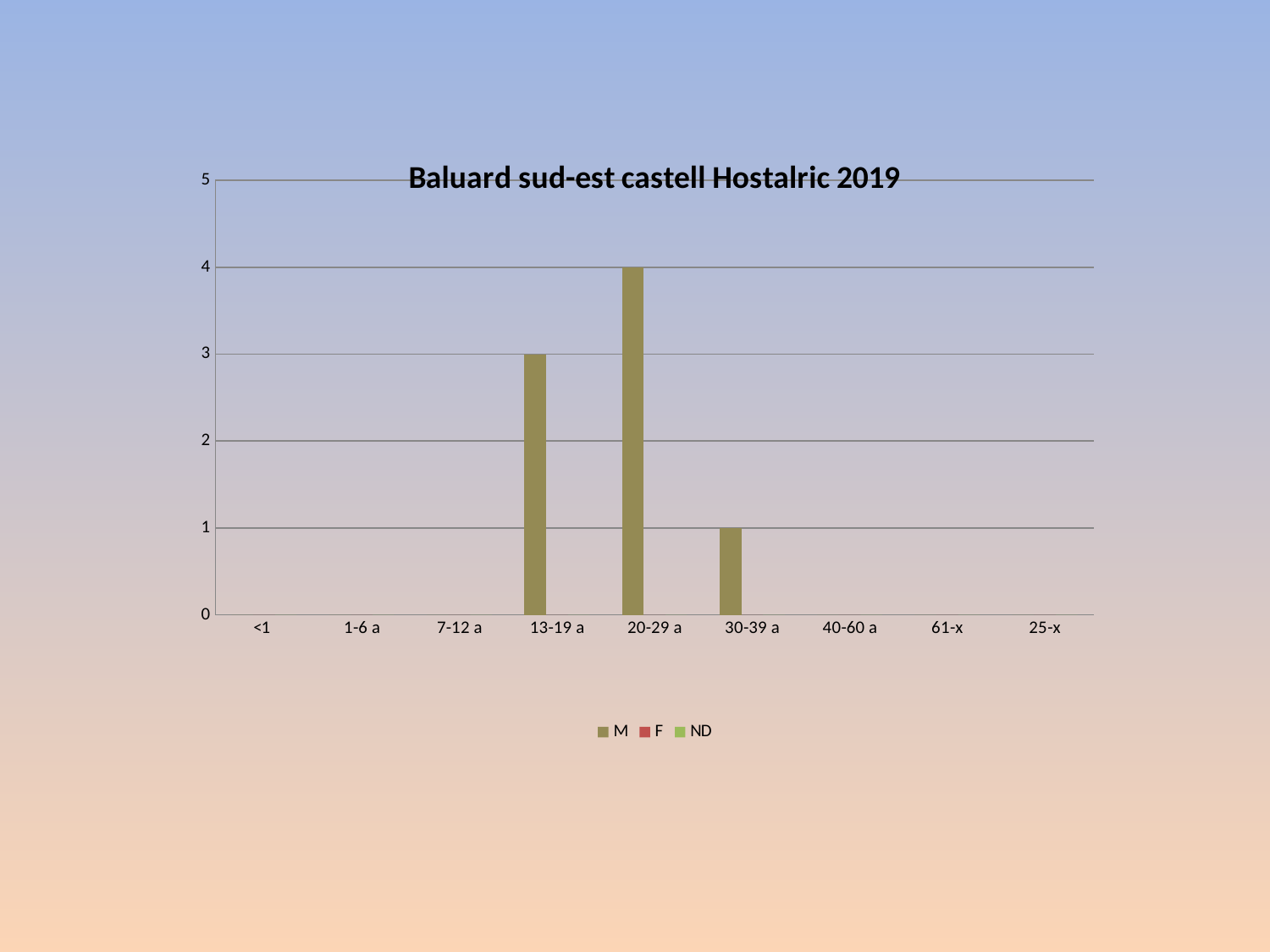
How many series does the legend list? 3 What is the title of the chart? Baluard sud-est castell Hostalric 2019 Which is larger, the M value for 13-19 a or for 30-39 a? 13-19 a What is the value of M for the 30-39 a category? 1 Which category has the highest value for M? 20-29 a What is the value of M for the 20-29 a category? 4 Is the value of M for 20-29 a greater or less than 2? greater What is the value of M for the 13-19 a category? 3 What type of chart is shown on the slide? bar chart Which series are listed in the legend? M, F, ND How many categories are shown on the x axis? 9 What is the difference between the M values for 20-29 a and 30-39 a? 3